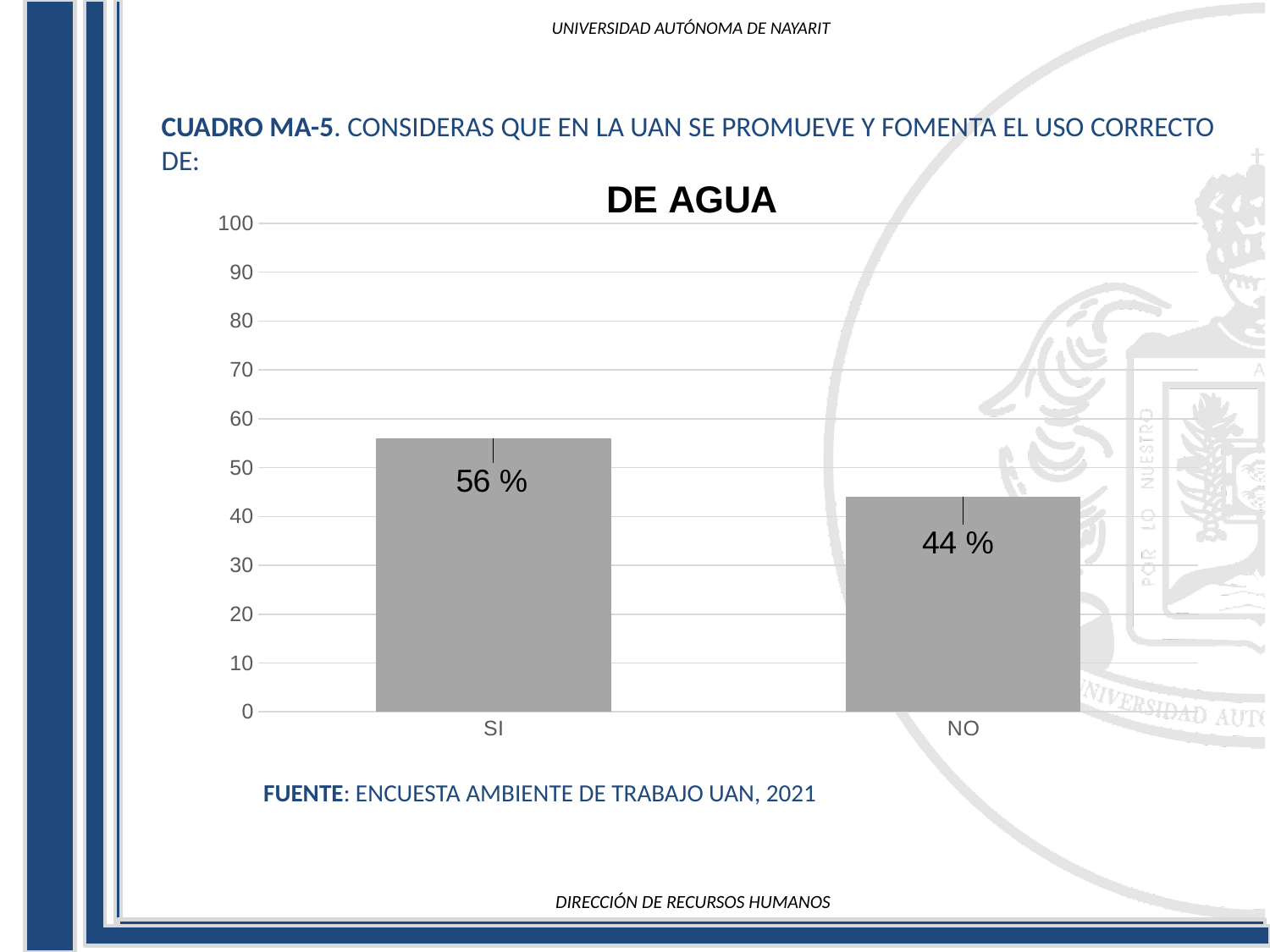
Is the value for SI greater or less than 50? greater What is the maximum value shown on the y axis? 100 Which category has the lowest value? NO What is the difference between the values for SI and NO? 12 % Which category has the highest value? SI What is the value for NO? 44 % Is the value for NO greater or less than 50? less What is the value for SI? 56 % How many categories are shown on the x axis? 2 Which is larger, the value for SI or the value for NO? SI What kind of chart is shown? bar chart What is the title of the chart? DE AGUA